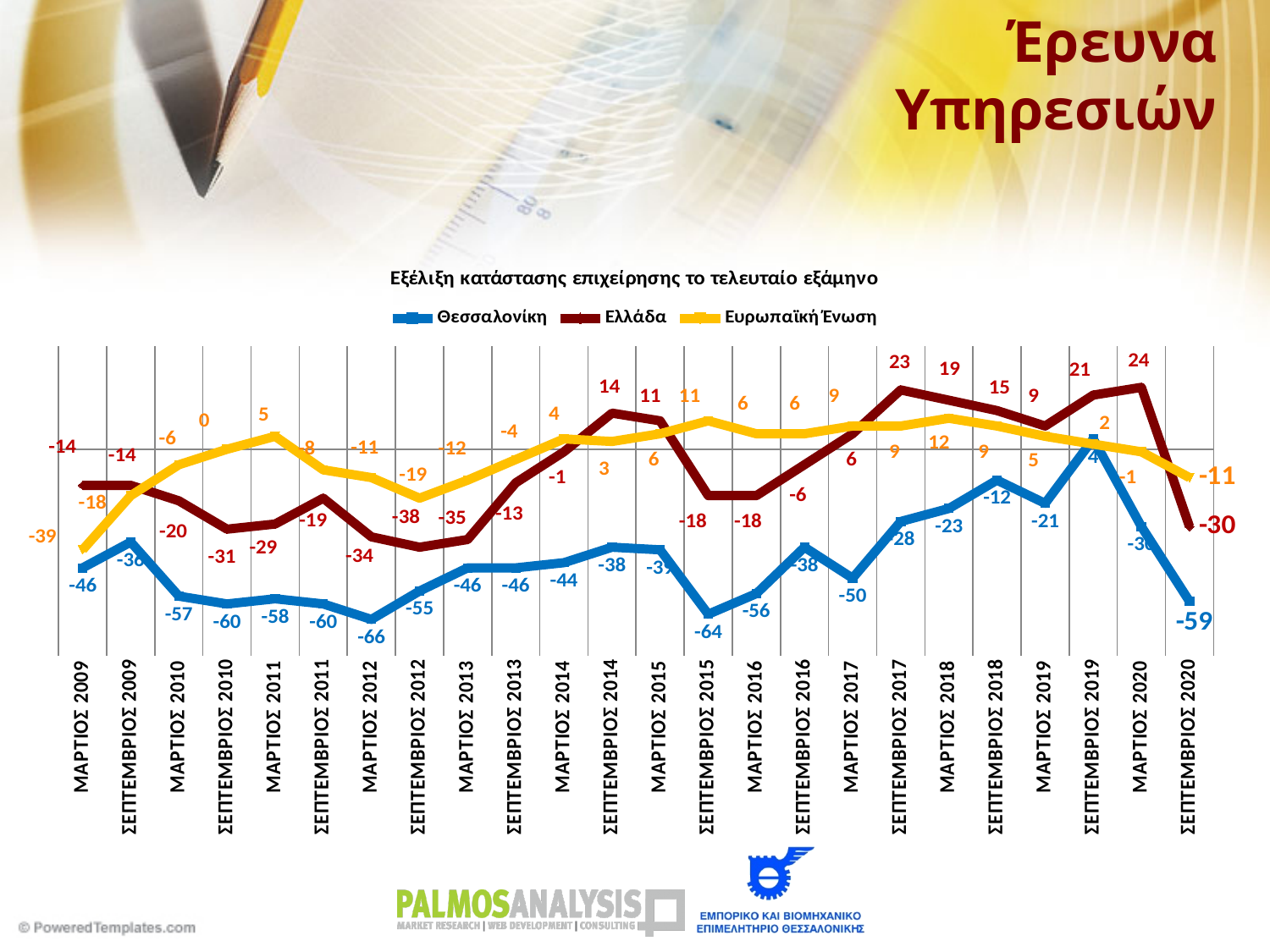
By how much did the value for Ελλάδα change between ΜΑΡΤΙΟΣ 2020 and ΣΕΠΤΕΜΒΡΙΟΣ 2020? 54 How many time points are plotted along the x axis of the chart? 24 What kind of chart is shown on the slide? line chart What is the value for Ελλάδα in ΜΑΡΤΙΟΣ 2020? 24 In which period does Θεσσαλονίκη reach its lowest value? ΜΑΡΤΙΟΣ 2012 How many series does the chart legend list? 3 In which period does Θεσσαλονίκη reach its highest value? ΣΕΠΤΕΜΒΡΙΟΣ 2019 What is the value for Ελλάδα in ΣΕΠΤΕΜΒΡΙΟΣ 2020? -30 What is the title of the chart? Εξέλιξη κατάστασης επιχείρησης το τελευταίο εξάμηνο What is the value for Ευρωπαϊκή Ένωση in ΣΕΠΤΕΜΒΡΙΟΣ 2020? -11 Which series has the highest value in ΣΕΠΤΕΜΒΡΙΟΣ 2020? Ευρωπαϊκή Ένωση What is the value for Θεσσαλονίκη in ΣΕΠΤΕΜΒΡΙΟΣ 2020? -59